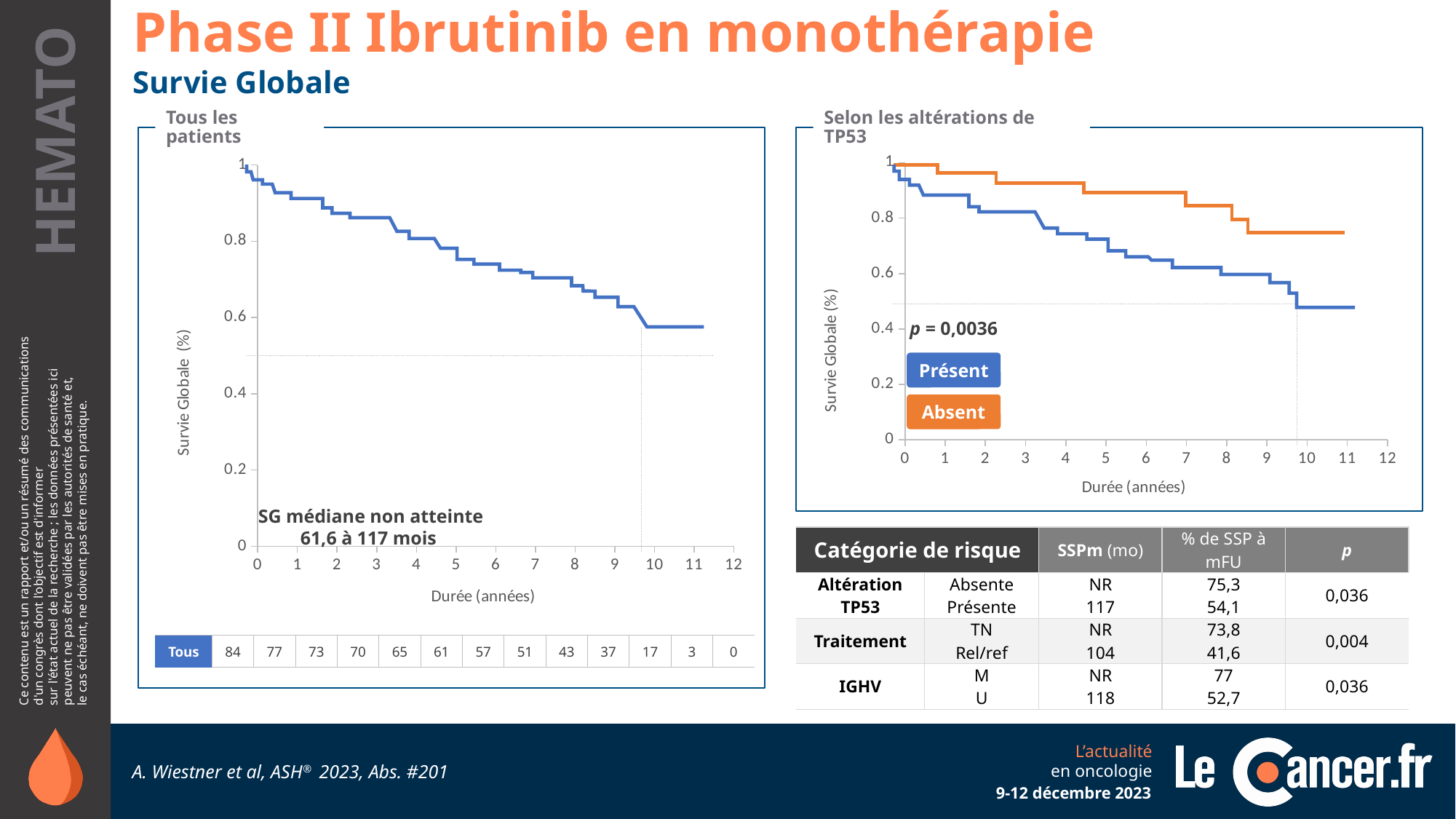
In the 'Selon les altérations de TP53' chart, is the 'Présent' curve at 10 years greater or less than 0.6? less In the 'Tous les patients' chart, what is the difference between the number at risk at time 0 and at 10 years? 67 In the 'Tous les patients' chart, do the survival values rise or fall along the x axis? fall In the 'Tous les patients' chart, how many patients are at risk ('Tous') at time 0? 84 What are the two legend entries on the 'Selon les altérations de TP53' chart? Présent and Absent How many series does the legend of the 'Selon les altérations de TP53' chart list? 2 In the 'Selon les altérations de TP53' chart, which series is higher at 8 years, 'Présent' or 'Absent'? Absent How many number-at-risk values are shown in the 'Tous' row under the 'Tous les patients' chart? 13 What kind of chart is the 'Tous les patients' chart? line chart What is the x-axis label of the 'Tous les patients' chart? Durée (années) In the 'Tous les patients' chart, is the survival value at 5 years greater or less than 0.6? greater In the 'Tous les patients' chart, how many patients are at risk ('Tous') at 10 years? 17